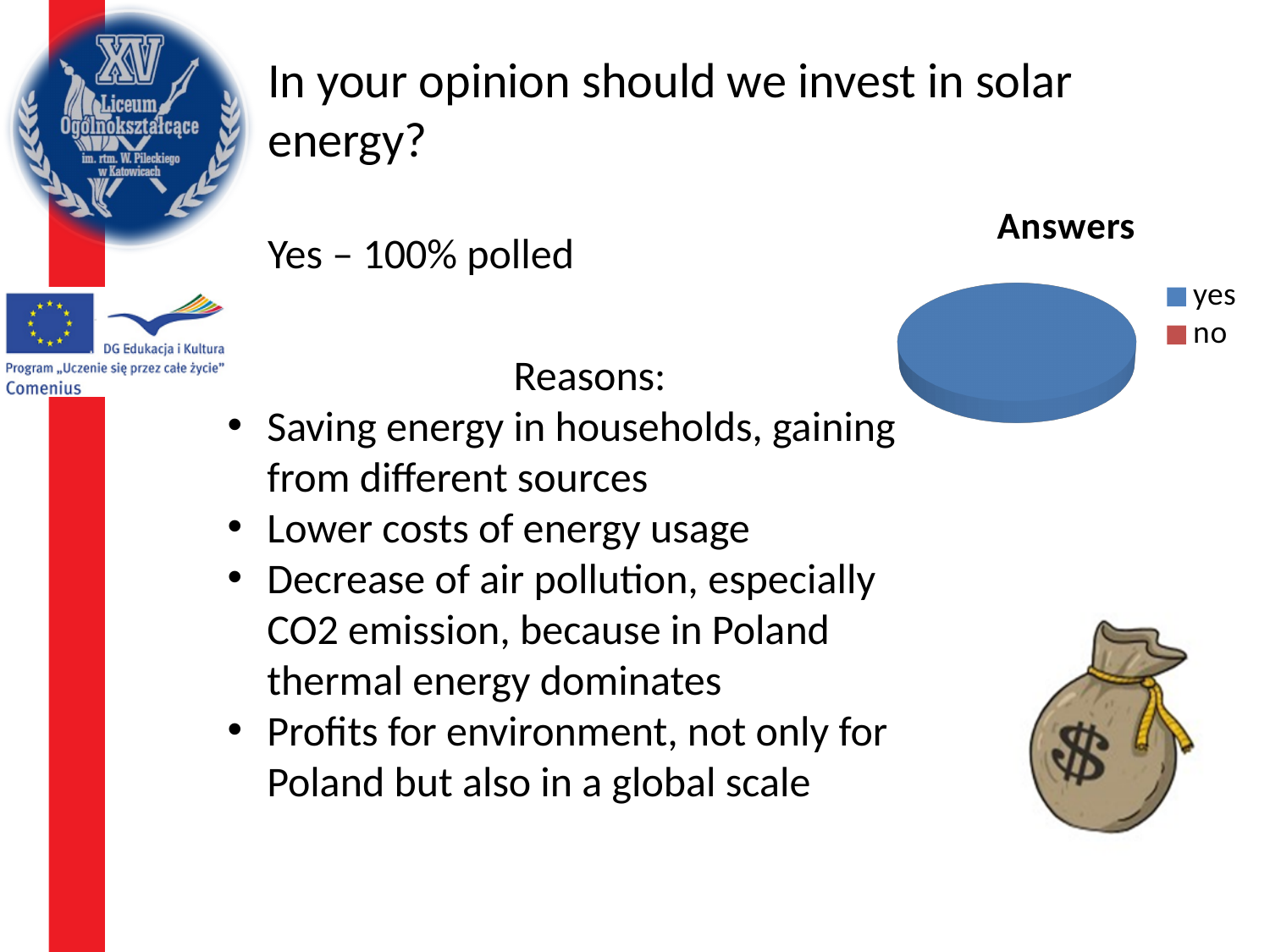
How many entries does the chart's legend list? 2 Which is larger in the pie chart, the share for yes or the share for no? yes What share of the pie does the yes answer take? 100% Which answer has the smallest share of the pie? no Which answer has the largest share of the pie? yes What colour represents the yes answer in the chart? blue What is the title of the chart? Answers What kind of chart is shown on the slide? pie chart